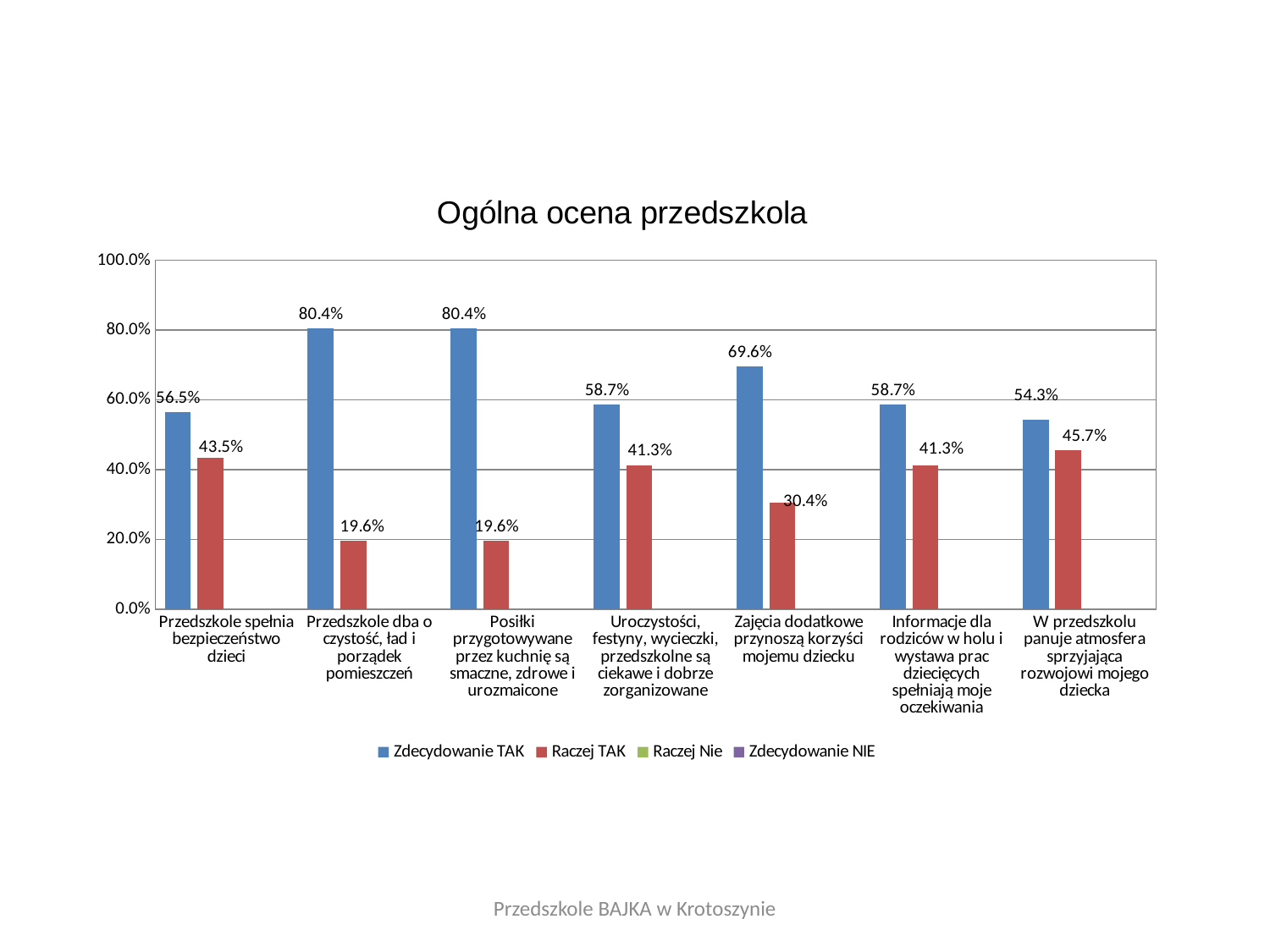
What kind of chart is shown on the slide? bar chart What is the 'Zdecydowanie TAK' value for 'Przedszkole spełnia bezpieczeństwo dzieci'? 56.5% Which is larger: the 'Zdecydowanie TAK' value for 'Zajęcia dodatkowe przynoszą korzyści mojemu dziecku' or the 'Zdecydowanie TAK' value for 'Uroczystości, festyny, wycieczki, przedszkolne są ciekawe i dobrze zorganizowane'? Zajęcia dodatkowe przynoszą korzyści mojemu dziecku How many series does the legend list? 4 Is the 'Raczej TAK' value for 'Informacje dla rodziców w holu i wystawa prac dziecięcych spełniają moje oczekiwania' greater or less than 40.0%? greater How many categories are shown on the x axis? 7 What is the difference between the 'Zdecydowanie TAK' and 'Raczej TAK' values for 'Przedszkole dba o czystość, ład i porządek pomieszczeń'? 60.8% Which category has the lowest 'Zdecydowanie TAK' value? W przedszkolu panuje atmosfera sprzyjająca rozwojowi mojego dziecka What is the 'Zdecydowanie TAK' value for 'W przedszkolu panuje atmosfera sprzyjająca rozwojowi mojego dziecka'? 54.3% Which category has the highest 'Raczej TAK' value? W przedszkolu panuje atmosfera sprzyjająca rozwojowi mojego dziecka What is the title of the chart? Ogólna ocena przedszkola What is the 'Raczej TAK' value for 'Zajęcia dodatkowe przynoszą korzyści mojemu dziecku'? 30.4%